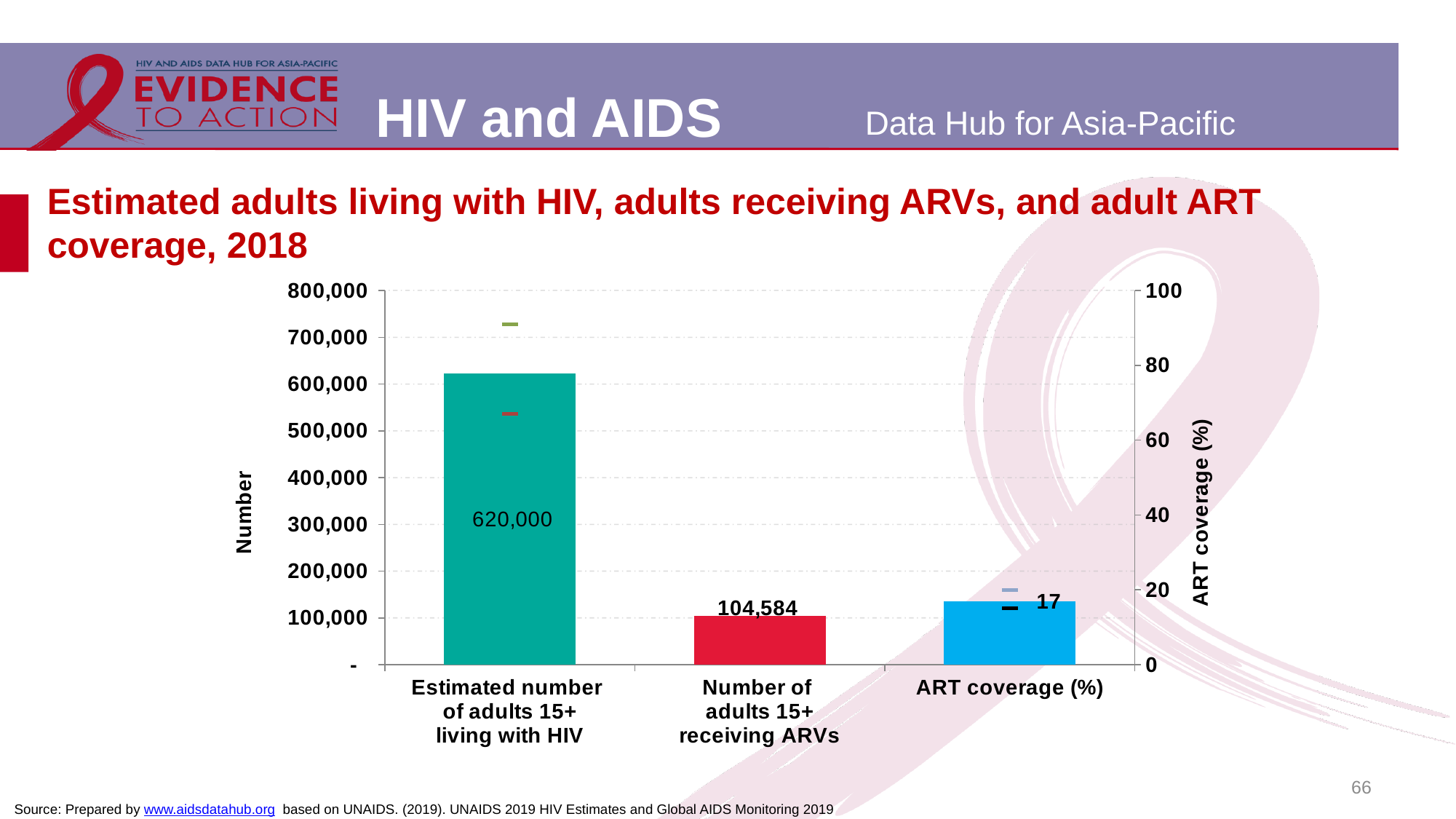
How many categories are shown on the x axis of the chart? 3 What is the label of the left-hand vertical axis of the chart? Number Is the value for the number of adults 15+ receiving ARVs greater or less than 200,000? less What is the difference between the estimated number of adults 15+ living with HIV and the number of adults 15+ receiving ARVs? 515,416 Which is larger: the estimated number of adults 15+ living with HIV or the number of adults 15+ receiving ARVs? Estimated number of adults 15+ living with HIV Is the ART coverage (%) value greater or less than 20 on the right-hand axis? less What is the number of adults 15+ receiving ARVs shown on the chart? 104,584 What is the estimated number of adults 15+ living with HIV shown on the chart? 620,000 Which category has the tallest bar on the chart? Estimated number of adults 15+ living with HIV What is the ART coverage (%) value shown on the chart? 17 What kind of chart is shown on the slide? Bar chart What is the label of the right-hand vertical axis of the chart? ART coverage (%)